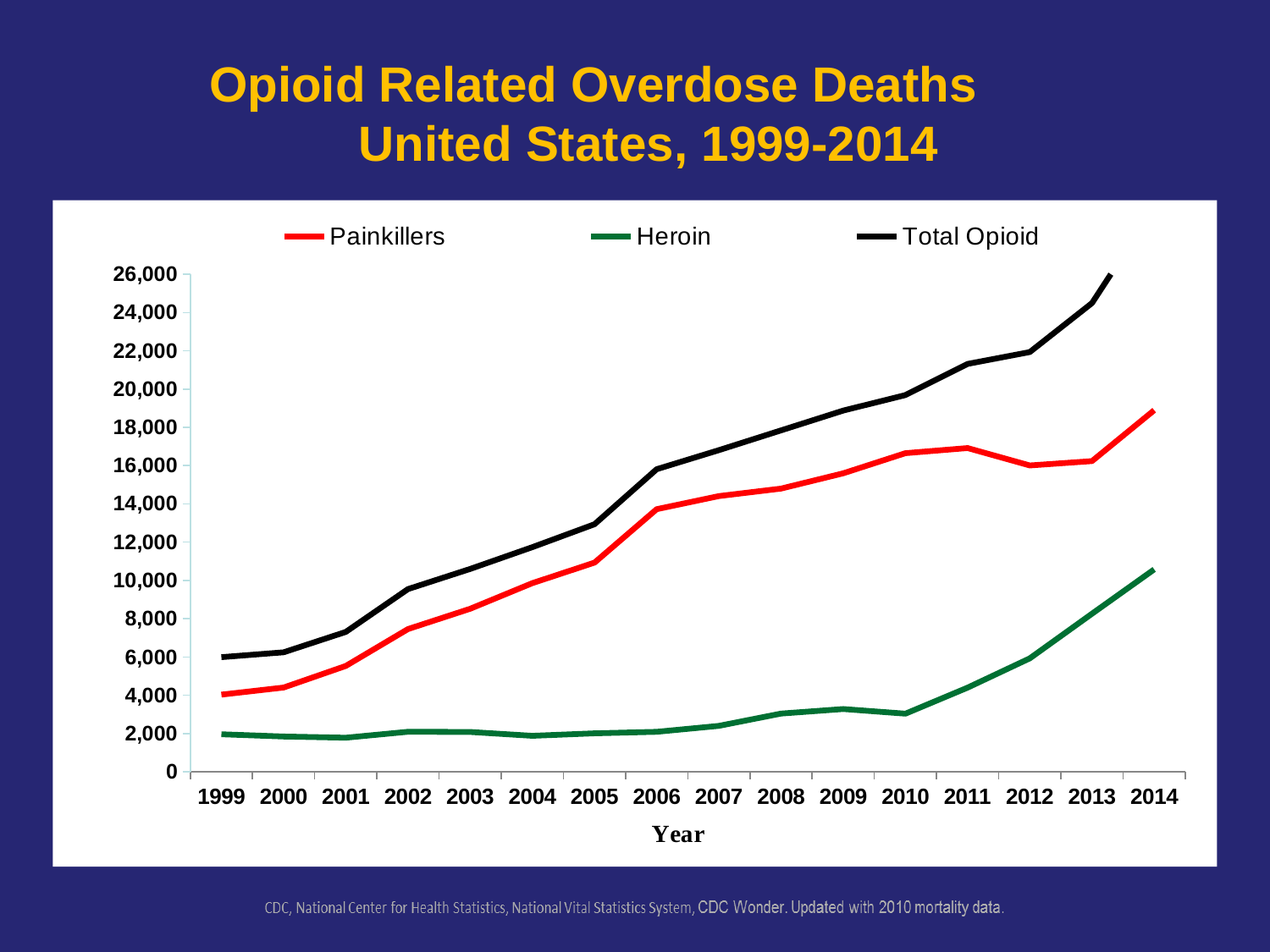
Which is larger in 2010, the value for Painkillers or the value for Heroin? Painkillers Which series has the highest value in 2014? Total Opioid Is the value for Total Opioid in 2014 greater or less than 24,000? greater Which series has the lowest value in 1999? Heroin How many years are plotted along the x axis? 16 In which year is the Total Opioid series at its highest? 2014 Does the Total Opioid series generally rise or fall from 1999 to 2014? Rise In which year is the Painkillers series at its lowest? 1999 How many series does the legend list? 3 What kind of chart is shown on the slide? Line chart Is the value for Heroin in 2005 greater or less than 4,000? less Is the value for Painkillers in 1999 greater or less than 6,000? less